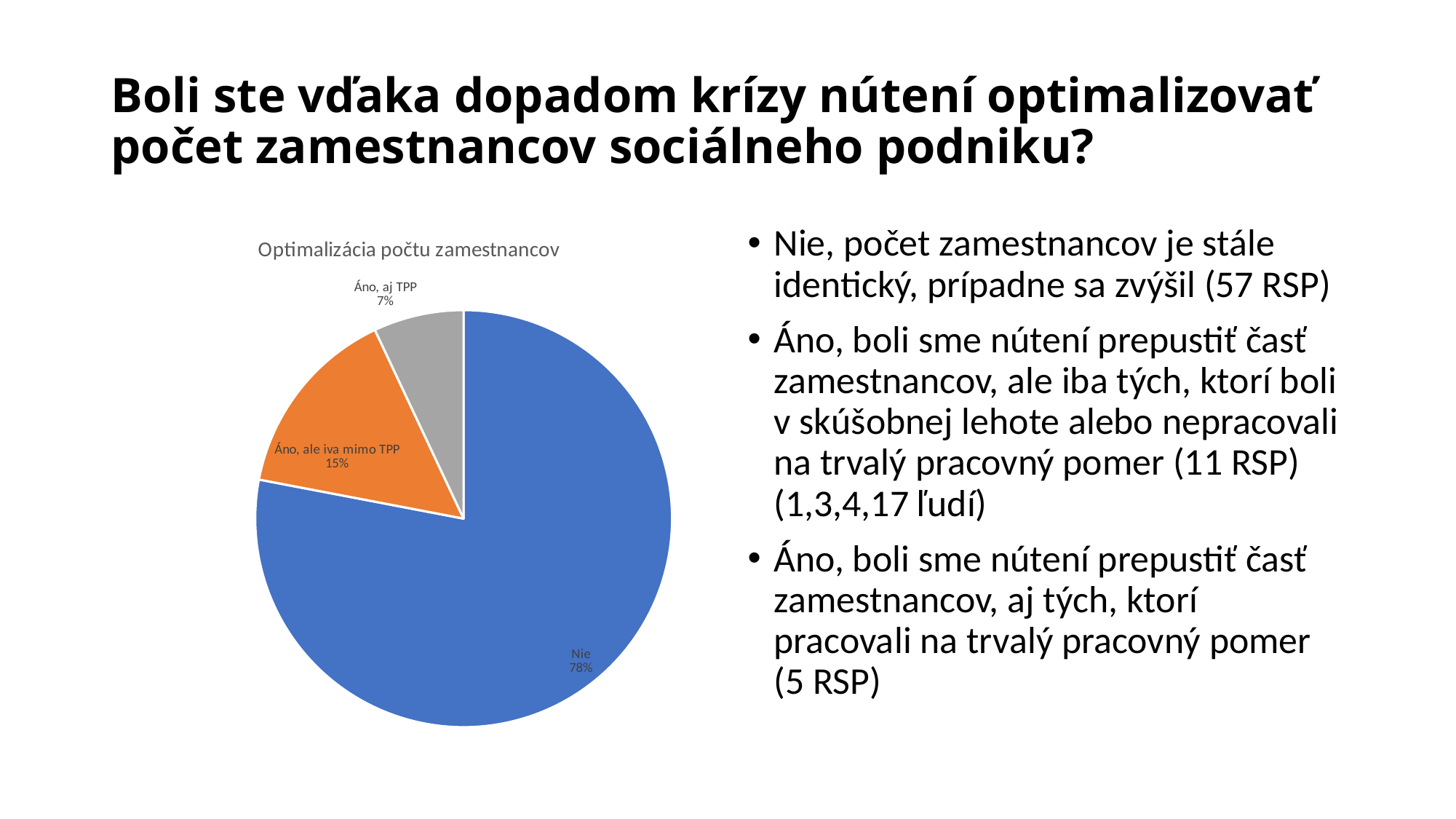
What type of chart is shown on the slide? Pie chart What is the title of the chart? Optimalizácia počtu zamestnancov What percentage share does the 'Nie' slice have? 78% What colour is the 'Nie' slice? Blue What is the combined share of the two 'Áno' slices? 22% What percentage share does the 'Áno, ale iva mimo TPP' slice have? 15% What percentage share does the 'Áno, aj TPP' slice have? 7% What is the difference in percentage points between the 'Nie' slice and the 'Áno, ale iva mimo TPP' slice? 63 percentage points How many slices does the pie chart have? 3 Which category has the largest share of the pie? Nie Which category has the smallest share of the pie? Áno, aj TPP Which slice is larger: 'Áno, ale iva mimo TPP' or 'Áno, aj TPP'? Áno, ale iva mimo TPP